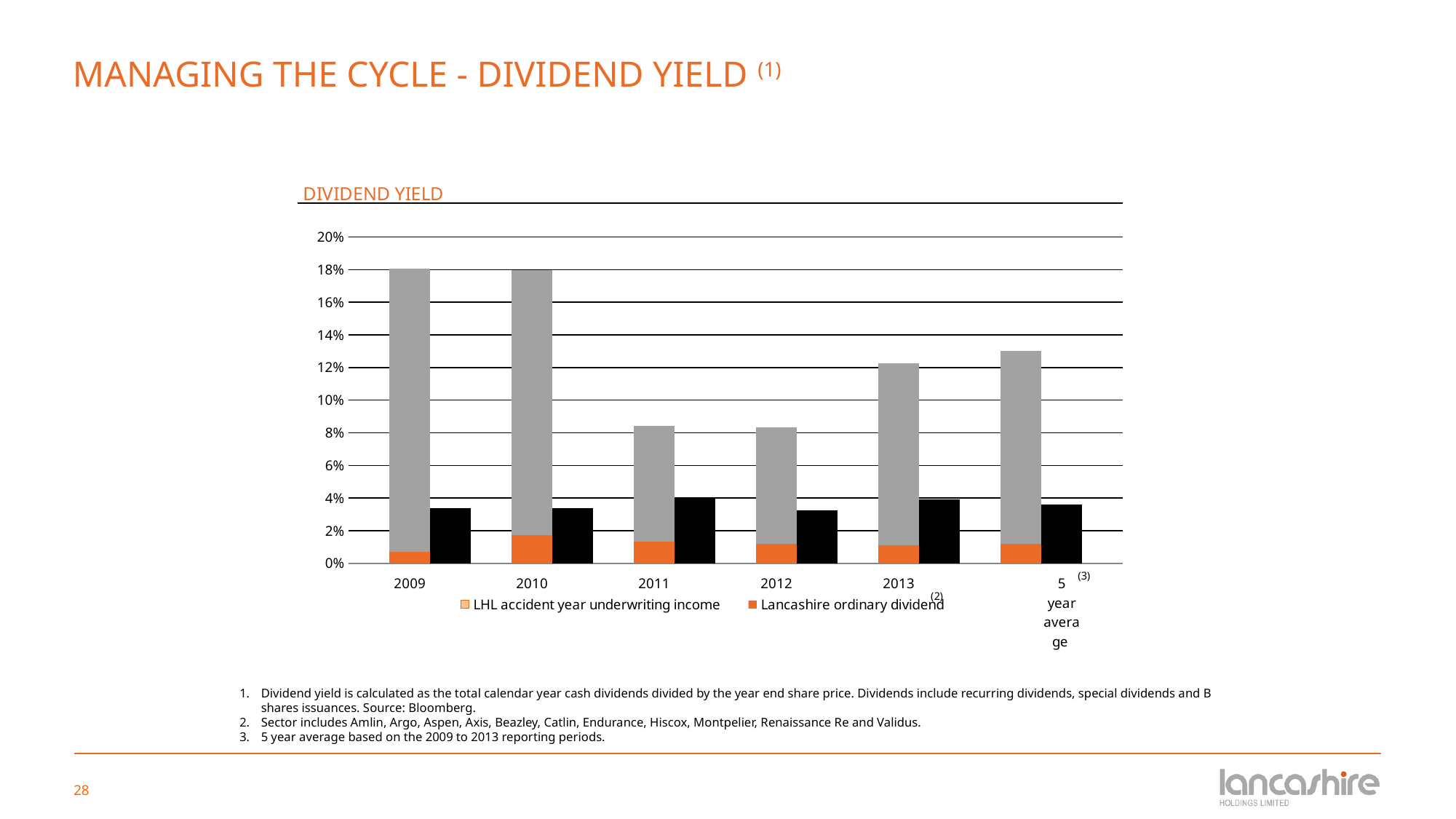
What is the title of the chart? DIVIDEND YIELD Which has the taller black bar, 2011 or 2012? 2011 Is the total height of the stacked bar for the 5 year average greater or less than 12%? greater Which has the taller stacked bar, 2009 or 2011? 2009 How many categories are shown along the x axis of the chart? 6 Is the black bar for 2011 greater or less than 2%? greater How many series does the chart's legend list? 2 Is the total height of the stacked bar for 2013 greater or less than 10%? greater Do the stacked bars rise or fall from 2009 to 2011? fall What kind of chart is shown on the slide? bar chart